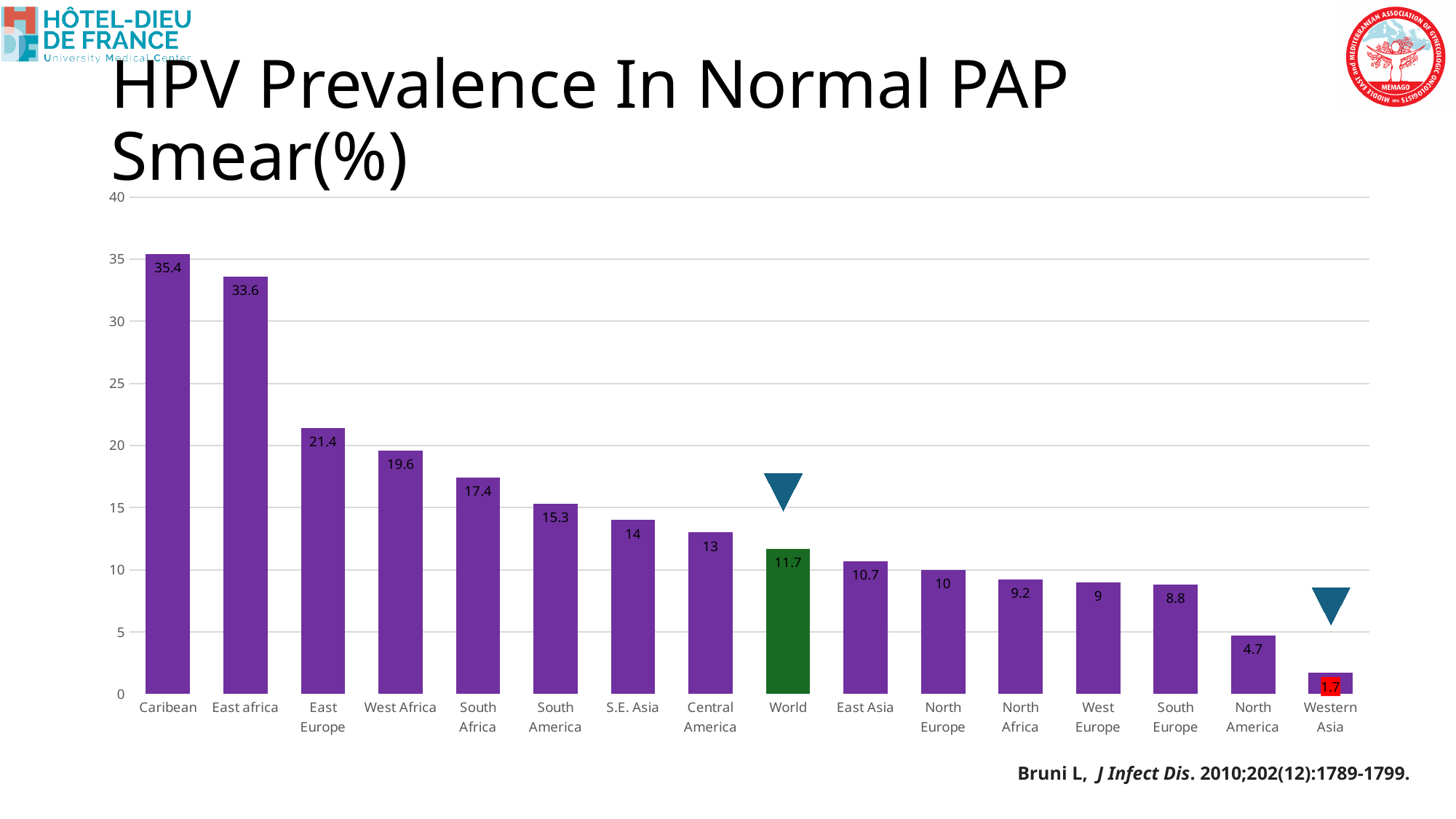
What is the difference between the World value and the Western Asia value? 10 Which region has the lowest HPV prevalence in the chart? Western Asia Which has a higher value, East Europe or West Africa? East Europe Which region has the highest HPV prevalence in the chart? Caribean What is the difference between the values for the Caribean and East africa? 1.8 How many regions are shown on the x axis of the chart? 16 What value is shown for Western Asia? 1.7 Which bar is coloured green rather than purple? World Is the value for South America greater or less than 20? less What value is shown for the World bar? 11.7 What kind of chart is shown on the slide? bar chart What is the HPV prevalence value shown for the Caribean? 35.4